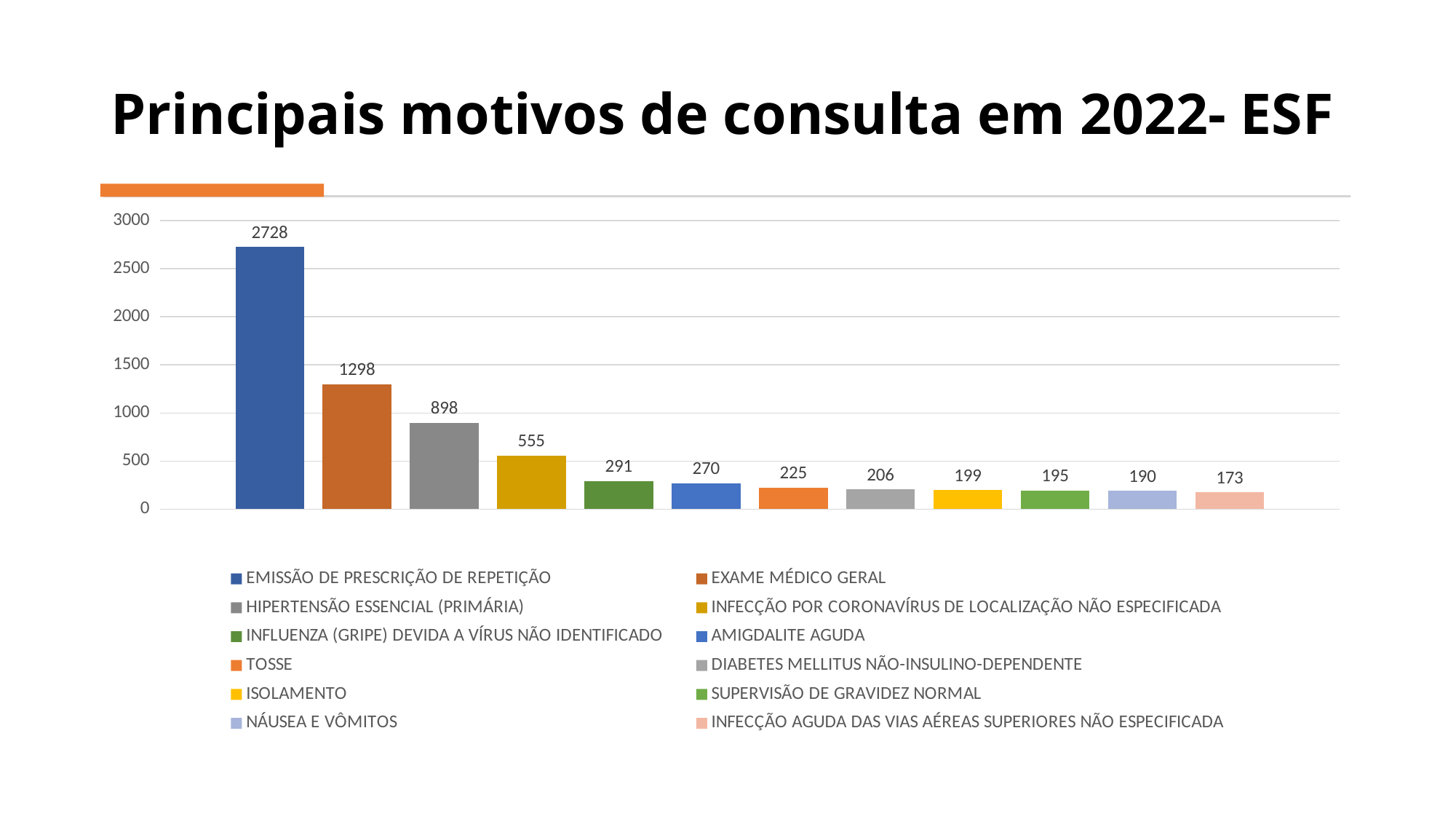
What is the difference between the values for EMISSÃO DE PRESCRIÇÃO DE REPETIÇÃO and EXAME MÉDICO GERAL? 1430 What is the value for EMISSÃO DE PRESCRIÇÃO DE REPETIÇÃO? 2728 What is the value for TOSSE? 225 How many bars are plotted in the chart? 12 Which category has the lowest value? INFECÇÃO AGUDA DAS VIAS AÉREAS SUPERIORES NÃO ESPECIFICADA Which is larger, the value for HIPERTENSÃO ESSENCIAL (PRIMÁRIA) or the value for INFECÇÃO POR CORONAVÍRUS DE LOCALIZAÇÃO NÃO ESPECIFICADA? HIPERTENSÃO ESSENCIAL (PRIMÁRIA) Is the value for AMIGDALITE AGUDA greater or less than 500? less What is the value for EXAME MÉDICO GERAL? 1298 What is the title of the chart? Principais motivos de consulta em 2022- ESF Which category has the highest value? EMISSÃO DE PRESCRIÇÃO DE REPETIÇÃO What kind of chart is shown on the slide? bar chart What is the value for INFECÇÃO POR CORONAVÍRUS DE LOCALIZAÇÃO NÃO ESPECIFICADA? 555